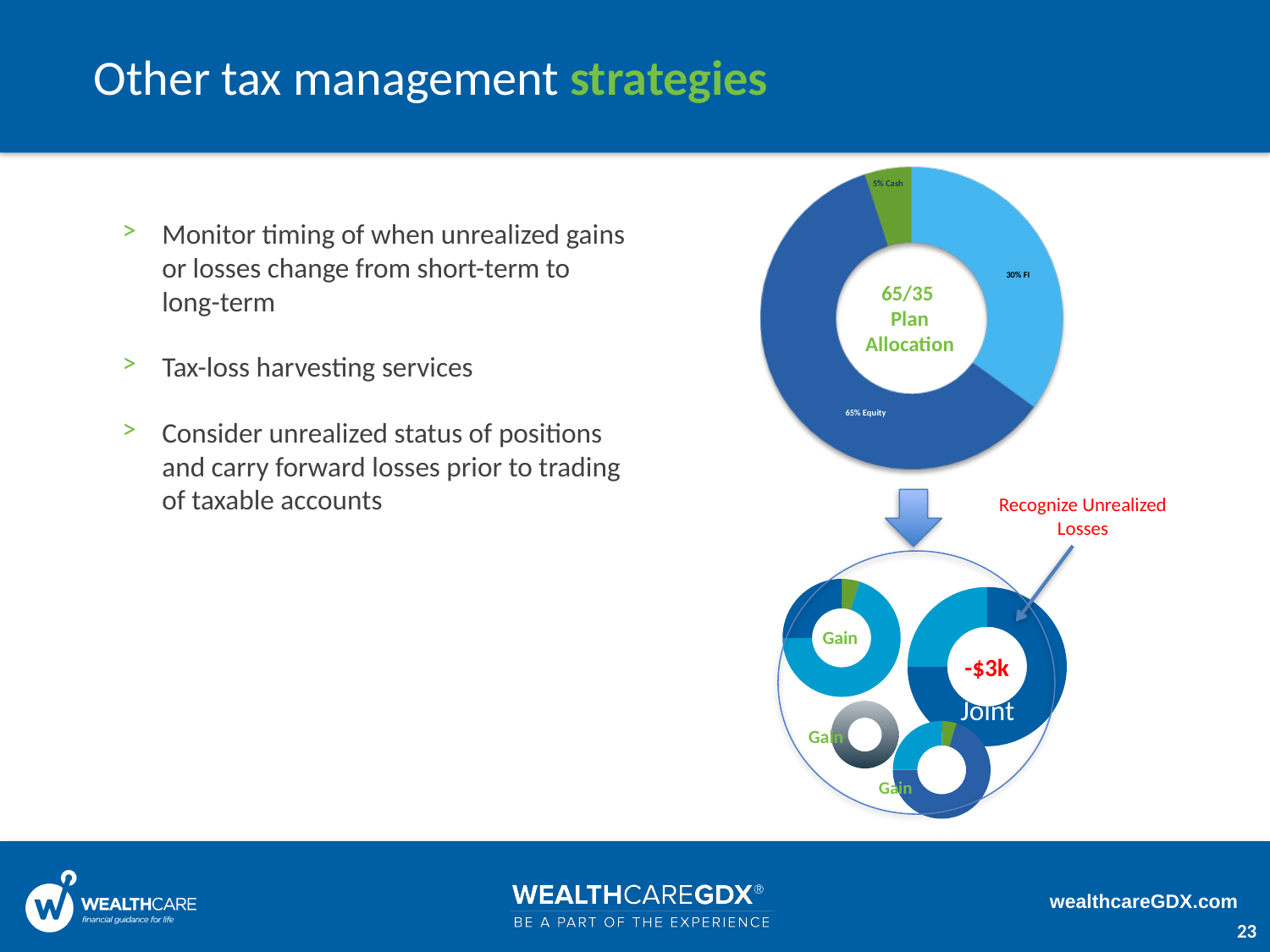
On the 65/35 Plan Allocation chart, which category has the smallest share? Cash What text is printed in the centre of the large donut chart on the slide? 65/35 Plan Allocation On the 65/35 Plan Allocation chart, what is the difference between the Equity share and the FI share? 35% What kind of chart is the 65/35 Plan Allocation chart? Donut (pie) chart On the 65/35 Plan Allocation chart, what do the FI and Cash shares add up to? 35% On the 65/35 Plan Allocation chart, which is larger, the FI share or the Cash share? FI On the 65/35 Plan Allocation chart, how many categories are shown? 3 On the 65/35 Plan Allocation chart, which category has the largest share? Equity What value is printed in the centre of the Joint donut chart at the bottom right of the slide? -$3k On the 65/35 Plan Allocation chart, what share is labelled for Cash? 5% On the 65/35 Plan Allocation chart, what share is labelled for FI? 30% On the 65/35 Plan Allocation chart, what share is labelled for Equity? 65%